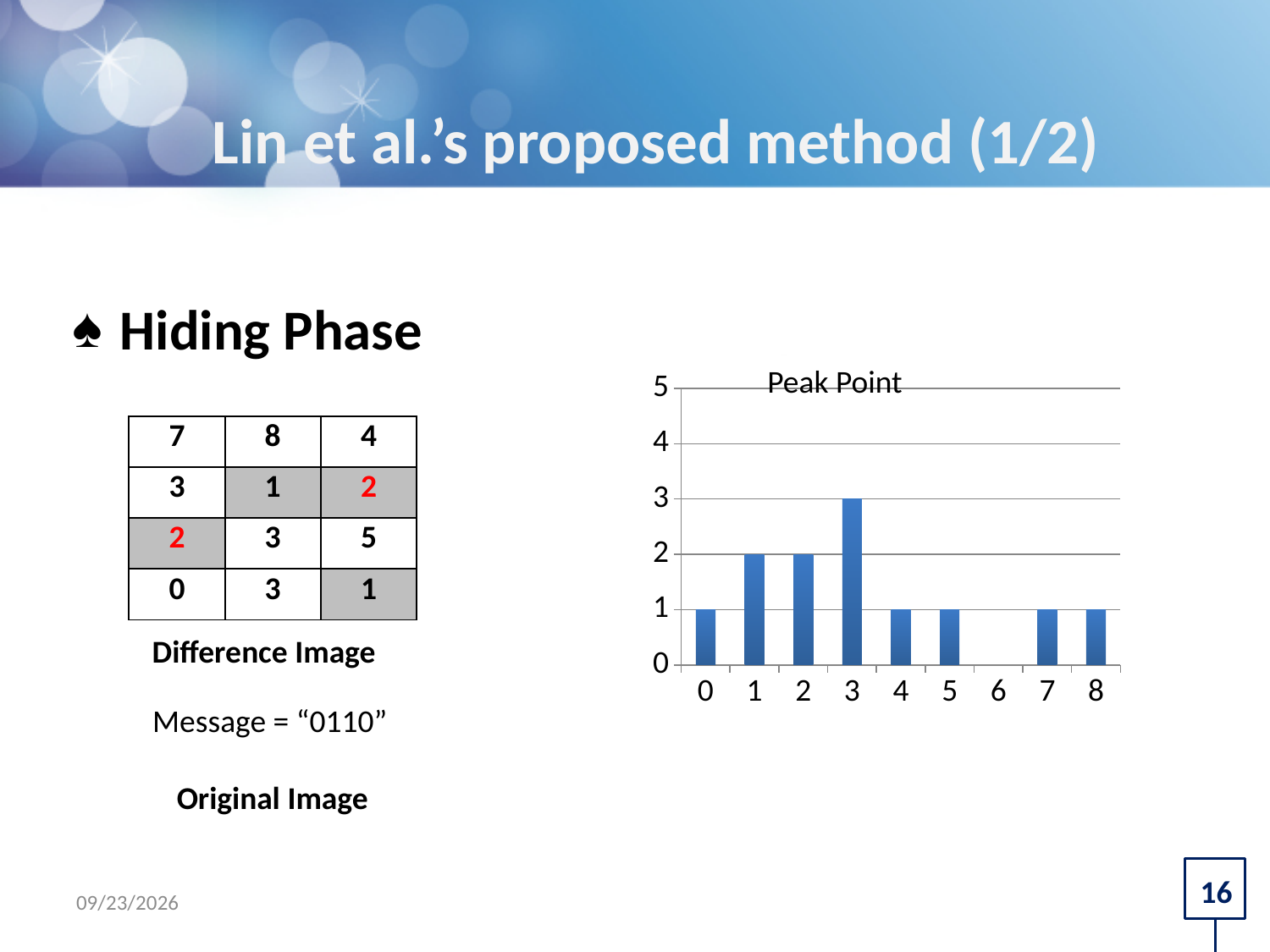
What is the difference between the value at x = 3 and the value at x = 2? 1 What is the value of the bar at x = 1? 2 What is the value of the bar at x = 3? 3 How many categories are labelled on the x axis? 9 Which is larger, the value at x = 1 or the value at x = 4? x = 1 Is the value at x = 3 greater or less than 2? greater Which x-axis category has the highest bar? 3 What type of chart is shown on the slide? bar chart What text label appears at the top of the chart? Peak Point What is the value at x = 6? 0 Which x-axis category has the lowest value? 6 What is the value of the bar at x = 0? 1